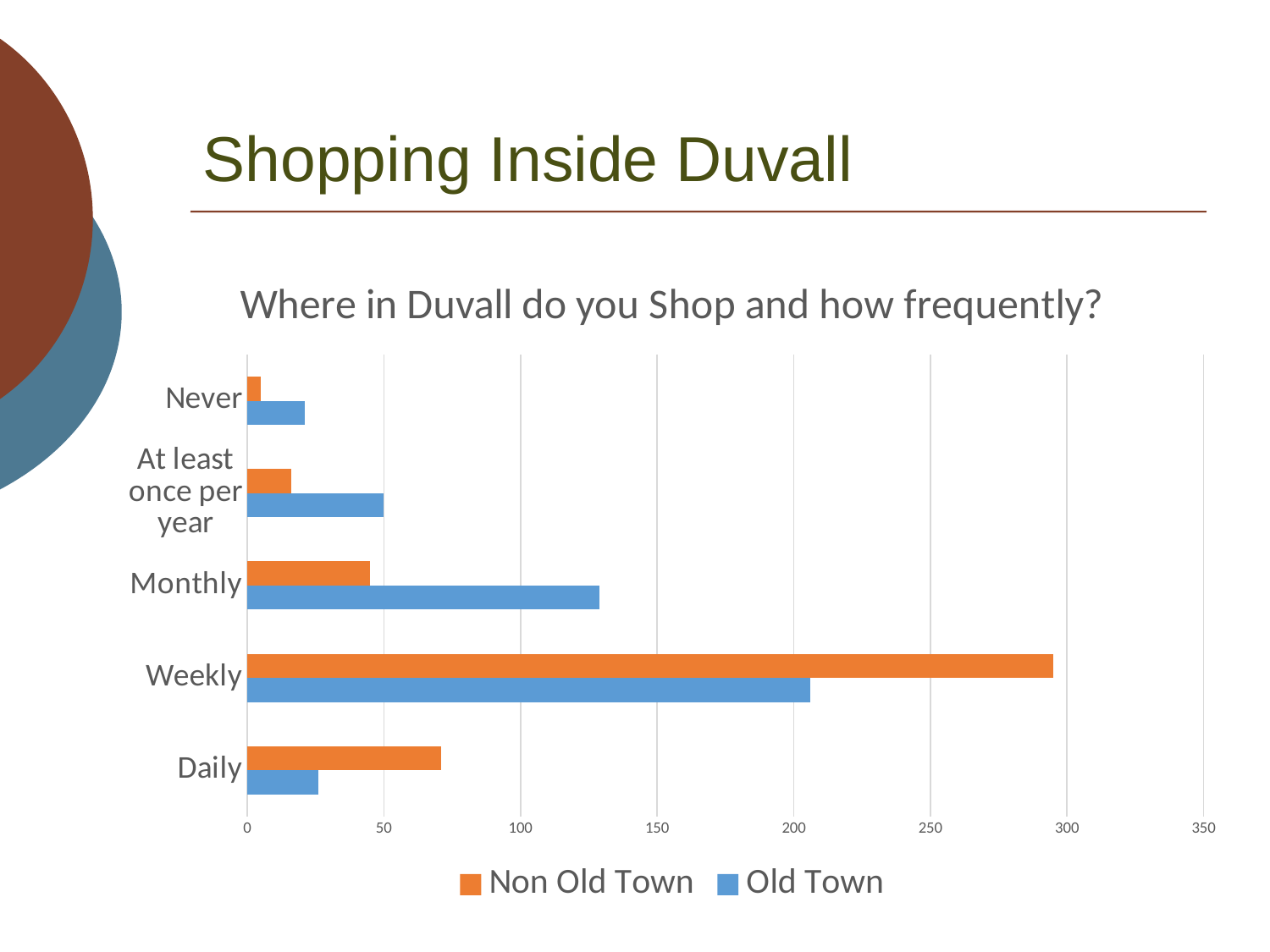
For Monthly, which is larger: Non Old Town or Old Town? Old Town Is the Non Old Town value for Weekly greater or less than 250? greater For Weekly, which is larger: Non Old Town or Old Town? Non Old Town For which category is the Non Old Town value lowest? Never How many series does the legend list? 2 What is the title of the chart? Where in Duvall do you Shop and how frequently? Which series is shown in orange? Non Old Town Is the Old Town value for Monthly greater or less than 100? greater How many frequency categories are shown on the chart? 5 For which category is the Old Town value highest? Weekly What kind of chart is shown on the slide? bar chart For which category is the Non Old Town value highest? Weekly